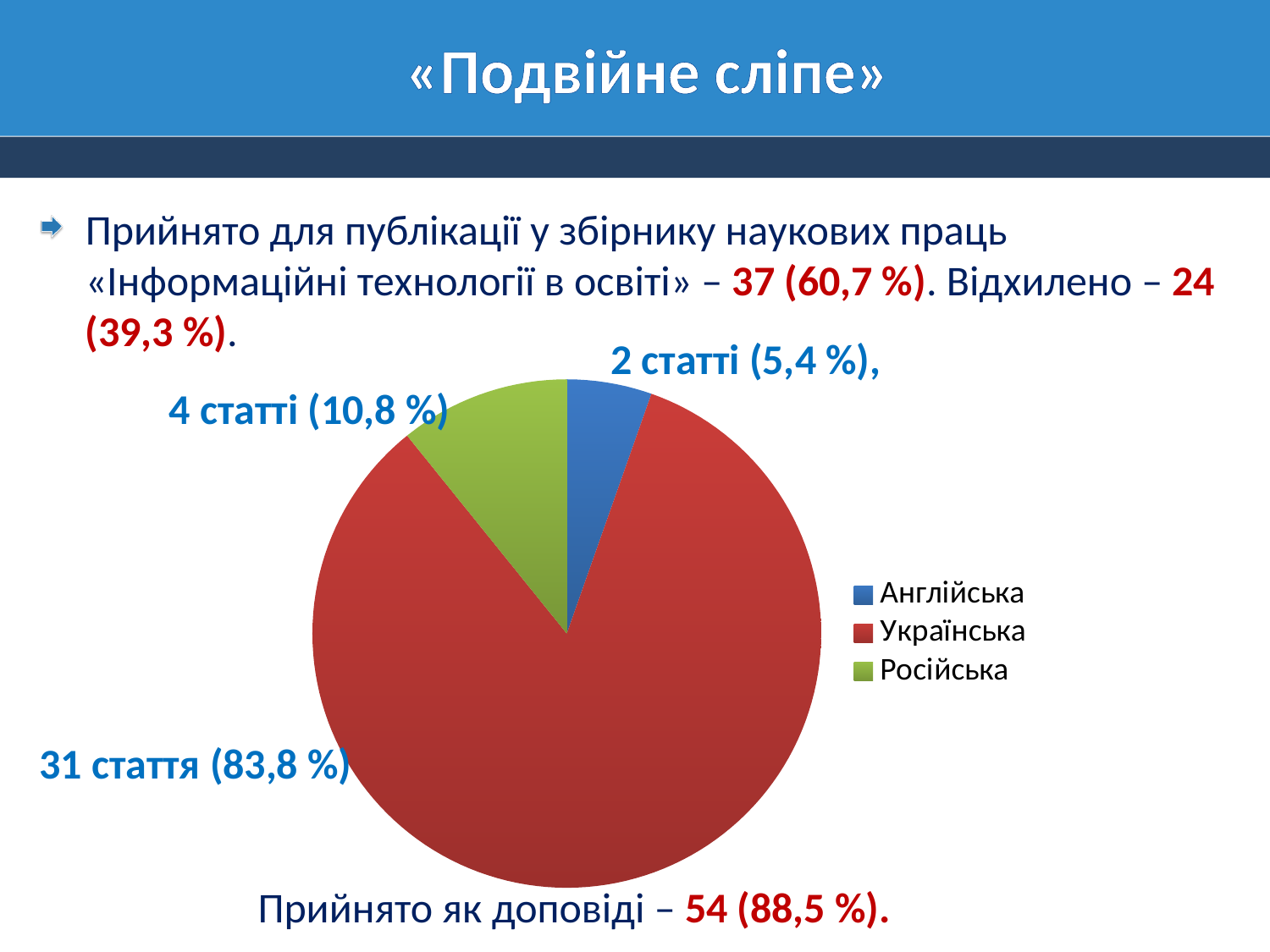
Which language has the largest slice of the pie? Українська Which colour represents Російська in the pie chart? green What share of the pie does the Англійська slice represent? 5,4 % How many articles does the Українська slice correspond to? 31 What share of the pie does the Російська slice represent? 10,8 % What kind of chart is shown on the slide? pie chart Which language has the smallest slice of the pie? Англійська What is the difference in number of articles between the Російська and Англійська slices? 2 What share of the pie does the Українська slice represent? 83,8 % How many slices does the pie chart have? 3 How many entries does the legend of the pie chart list? 3 How many articles does the Російська slice correspond to? 4